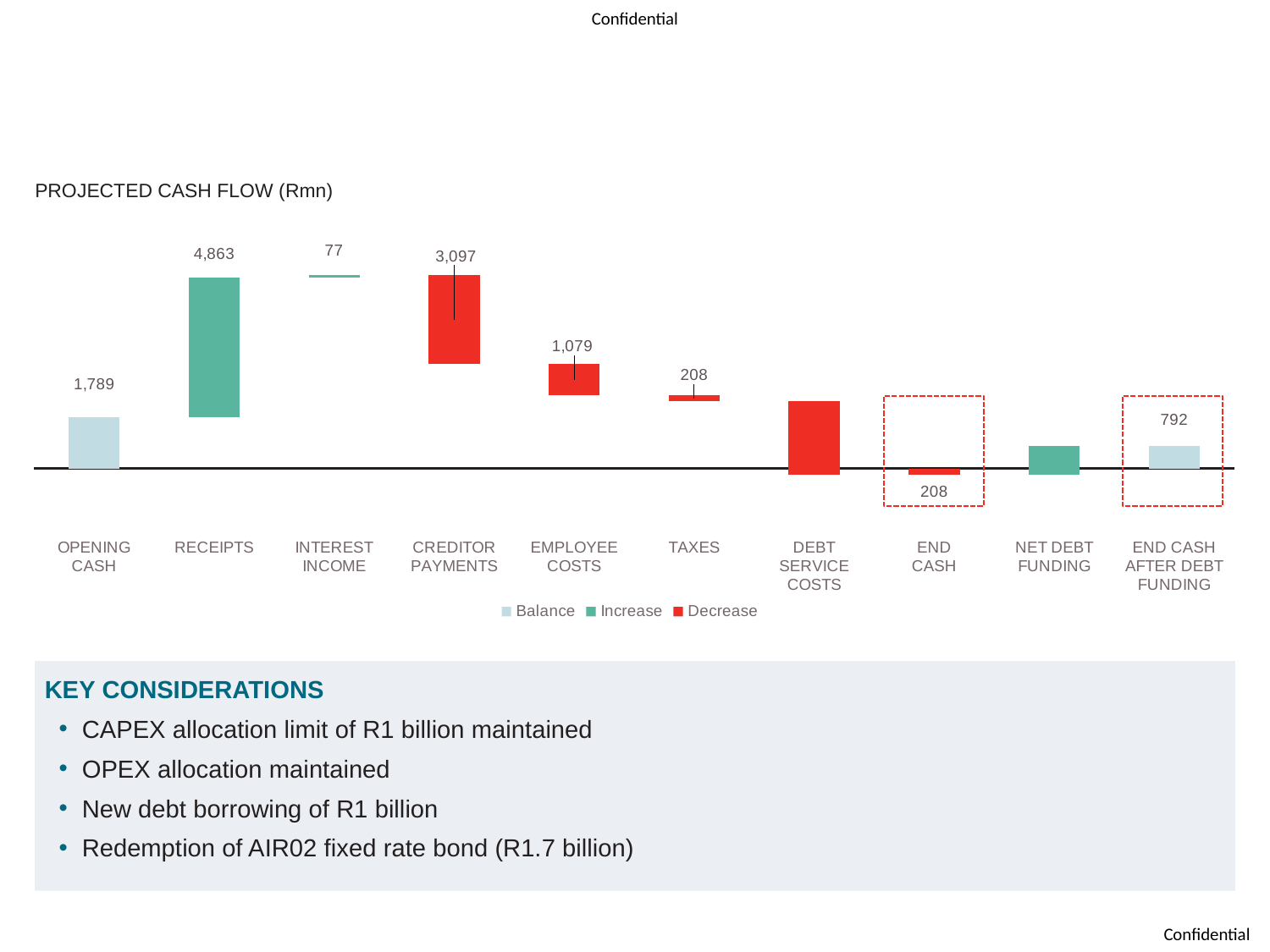
What is the value for INTEREST INCOME in the PROJECTED CASH FLOW (Rmn) chart? 77 What is the value for CREDITOR PAYMENTS in the PROJECTED CASH FLOW (Rmn) chart? 3,097 How many categories are shown on the x axis of the PROJECTED CASH FLOW (Rmn) chart? 10 What is the value for RECEIPTS in the PROJECTED CASH FLOW (Rmn) chart? 4,863 What is the difference between the EMPLOYEE COSTS value and the TAXES value in the PROJECTED CASH FLOW (Rmn) chart? 871 What is the value for END CASH AFTER DEBT FUNDING in the PROJECTED CASH FLOW (Rmn) chart? 792 What is the difference between the RECEIPTS value and the CREDITOR PAYMENTS value in the PROJECTED CASH FLOW (Rmn) chart? 1,766 Which category has the highest labelled value in the PROJECTED CASH FLOW (Rmn) chart? RECEIPTS What is the value for OPENING CASH in the PROJECTED CASH FLOW (Rmn) chart? 1,789 Which is larger in the PROJECTED CASH FLOW (Rmn) chart, CREDITOR PAYMENTS or EMPLOYEE COSTS? CREDITOR PAYMENTS What kind of chart is the PROJECTED CASH FLOW (Rmn) chart? Bar chart (waterfall) How many entries does the legend of the PROJECTED CASH FLOW (Rmn) chart list? 3